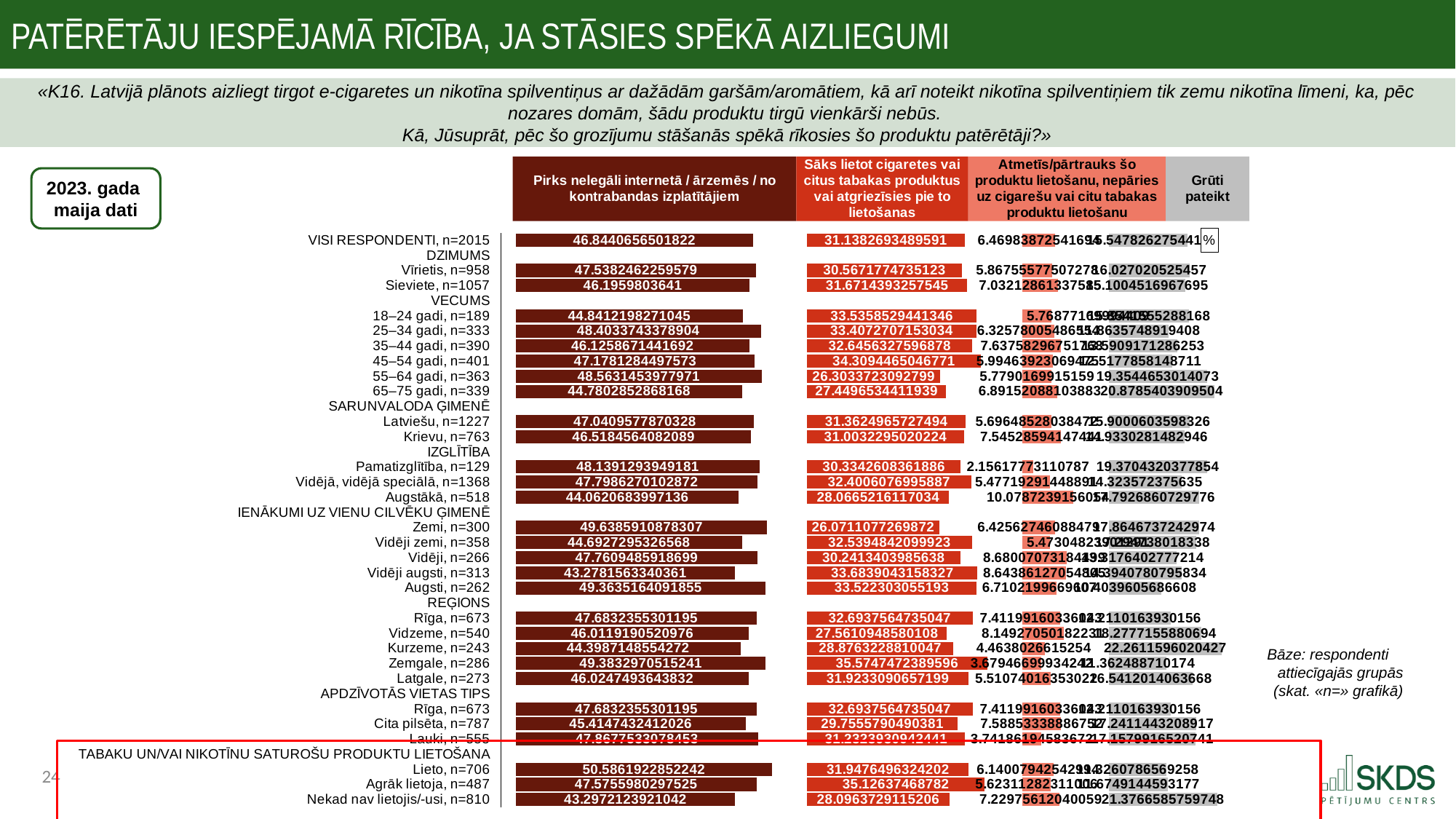
Which category has the highest value in the series "Pirks nelegāli internetā / ārzemēs / no kontrabandas izplatītājiem"? Lieto, n=706 What is the label of the last (grey) series in the chart? Grūti pateikt What is the value for "VISI RESPONDENTI, n=2015" in the series "Sāks lietot cigaretes vai citus tabakas produktus vai atgriezīsies pie to lietošanas"? 31.1382693489591 What kind of chart is shown on the slide? bar chart What is the value for "VISI RESPONDENTI, n=2015" in the series "Pirks nelegāli internetā / ārzemēs / no kontrabandas izplatītājiem"? 46.8440656501822 What is the value for "Zemi, n=300" in the series "Pirks nelegāli internetā / ārzemēs / no kontrabandas izplatītājiem"? 49.6385910878307 What is the value for "Zemgale, n=286" in the series "Sāks lietot cigaretes vai citus tabakas produktus vai atgriezīsies pie to lietošanas"? 35.5747472389596 What is the value for "Lieto, n=706" in the series "Pirks nelegāli internetā / ārzemēs / no kontrabandas izplatītājiem"? 50.5861922852242 What is the value for "Nekad nav lietojis/-usi, n=810" in the series "Sāks lietot cigaretes vai citus tabakas produktus vai atgriezīsies pie to lietošanas"? 28.0963729115206 How many series does the chart show (as listed in the column headers)? 4 In the series "Sāks lietot cigaretes vai citus tabakas produktus vai atgriezīsies pie to lietošanas", which is larger: "55–64 gadi, n=363" or "45–54 gadi, n=401"? 45–54 gadi, n=401 In the series "Pirks nelegāli internetā / ārzemēs / no kontrabandas izplatītājiem", which is larger: "Vīrietis, n=958" or "Sieviete, n=1057"? Vīrietis, n=958